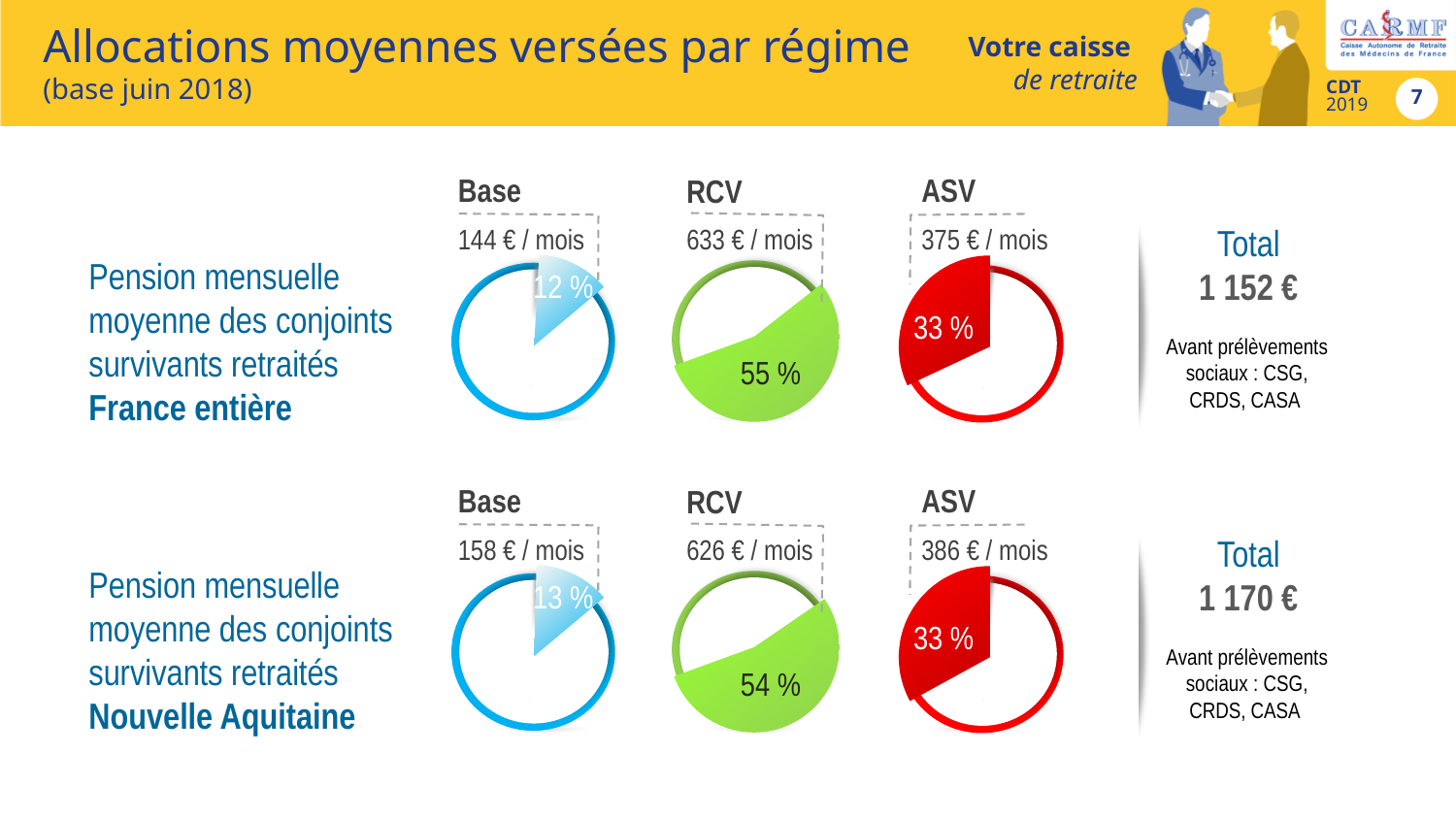
How many pie charts are shown on the slide in total? 6 What is the difference between the RCV amount for France entière and the RCV amount for Nouvelle Aquitaine? 7 € In the France entière row, what share does the RCV pie chart show? 55 % What kind of chart is used to show each regime's share on the slide? Pie chart In the France entière row, what is the average monthly Base pension shown? 144 € / mois What is the total average monthly pension shown for Nouvelle Aquitaine? 1 170 € In the Nouvelle Aquitaine row, which regime (Base, RCV or ASV) has the lowest average monthly amount? Base What is the total average monthly pension shown for France entière? 1 152 € In the Nouvelle Aquitaine row, what is the average monthly ASV pension shown? 386 € / mois Which is larger: the ASV amount for France entière or the ASV amount for Nouvelle Aquitaine? Nouvelle Aquitaine In the Nouvelle Aquitaine row, what share does the Base pie chart show? 13 % In the France entière row, which regime (Base, RCV or ASV) has the highest average monthly amount? RCV